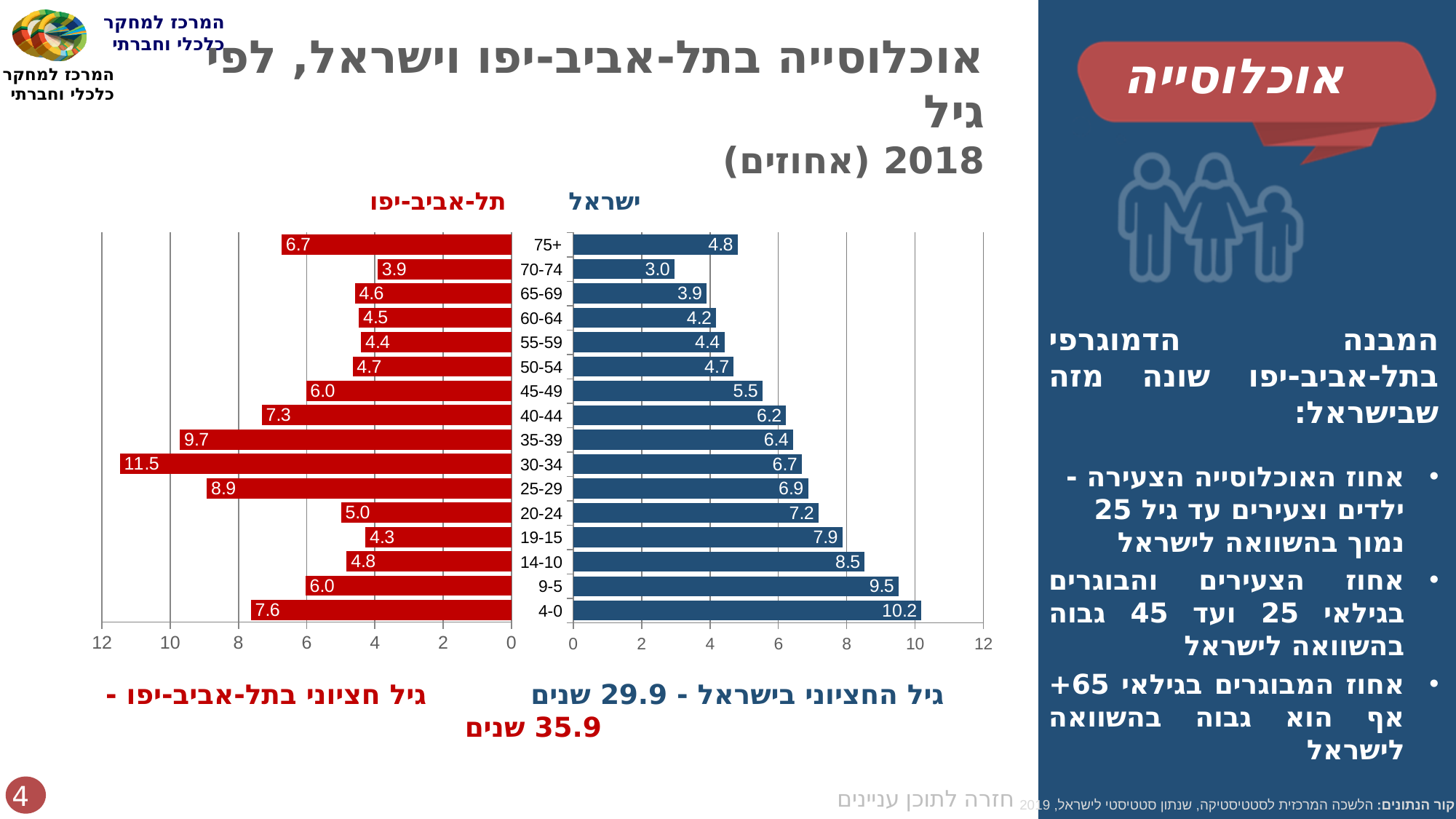
What kind of chart is shown on the slide? bar chart How many series does the chart show? 2 For the 14-10 age group, which is larger: the Tel Aviv-Yafo value or the Israel value? Israel Which age group has the highest value in the Israel (blue) series? 4-0 What is the value for the 4-0 age group in the Israel (blue) series? 10.2 What colour are the bars for the Israel series? blue Which age group has the lowest value in the Israel (blue) series? 70-74 What is the difference between the Tel Aviv-Yafo and Israel values for the 30-34 age group? 4.8 For the 75+ age group, which is larger: the Tel Aviv-Yafo value or the Israel value? Tel Aviv-Yafo How many age groups are shown on the chart? 16 Which age group has the highest value in the Tel Aviv-Yafo (red) series? 30-34 What is the value for the 30-34 age group in the Tel Aviv-Yafo (red) series? 11.5